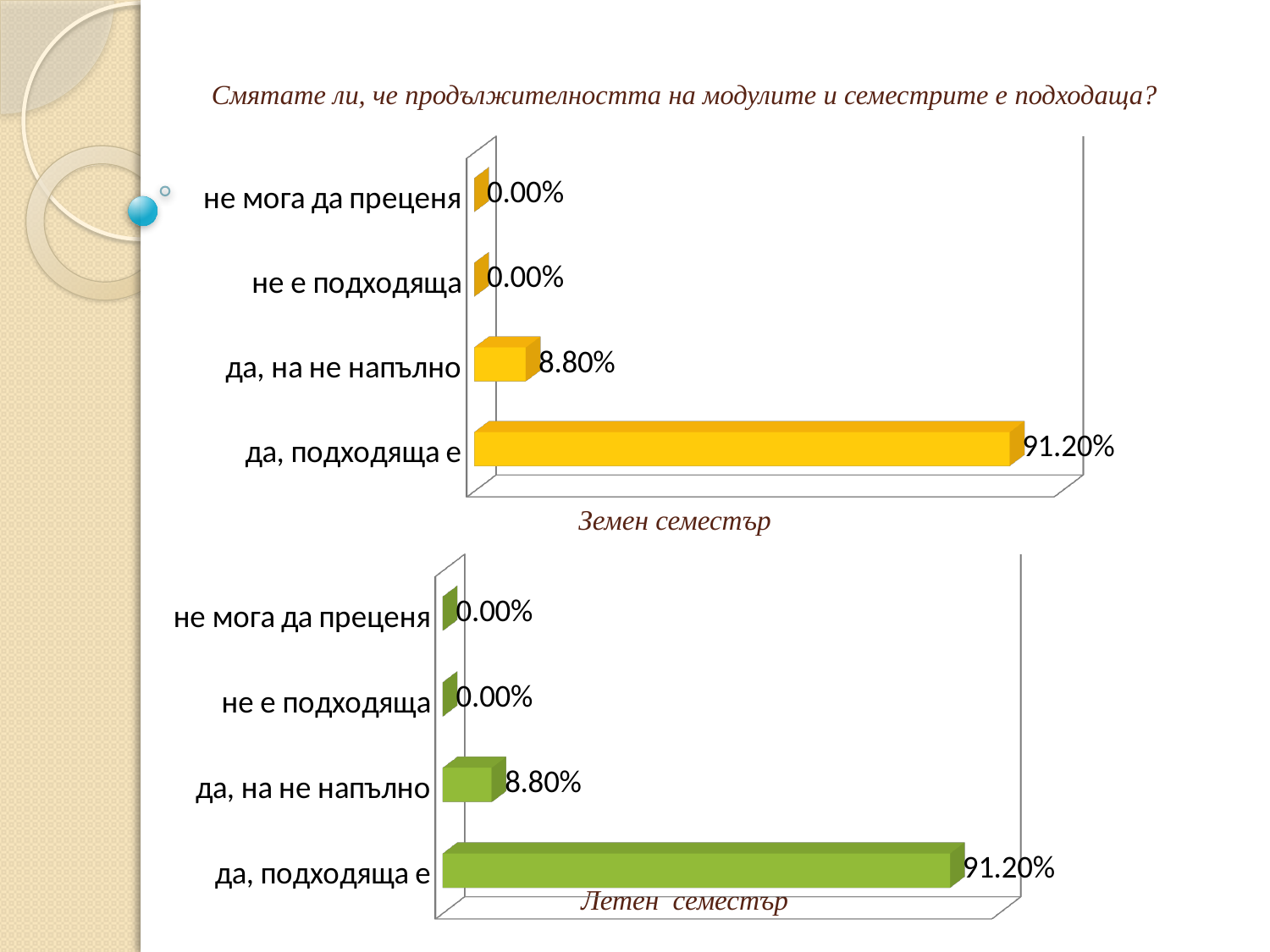
What is the title of the top chart? Земен семестър In the top chart (Земен семестър), which category has the highest value? да, подходяща е What kind of chart is the bottom chart (Летен семестър)? bar chart In the bottom chart (Летен семестър), which is larger: 'да, на не напълно' or 'не мога да преценя'? да, на не напълно In the bottom chart (Летен семестър), which category has the highest value? да, подходяща е In the bottom chart (Летен семестър), what is the value for 'не е подходяща'? 0.00% In the top chart (Земен семестър), what is the value for 'да, на не напълно'? 8.80% In the top chart (Земен семестър), what is the difference between 'да, подходяща е' and 'да, на не напълно'? 82.40% What colour are the bars in the bottom chart (Летен семестър)? green In the bottom chart (Летен семестър), what is the value for 'да, подходяща е'? 91.20% In the top chart (Земен семестър), what is the value for 'да, подходяща е'? 91.20% How many categories does the top chart (Земен семестър) show? 4